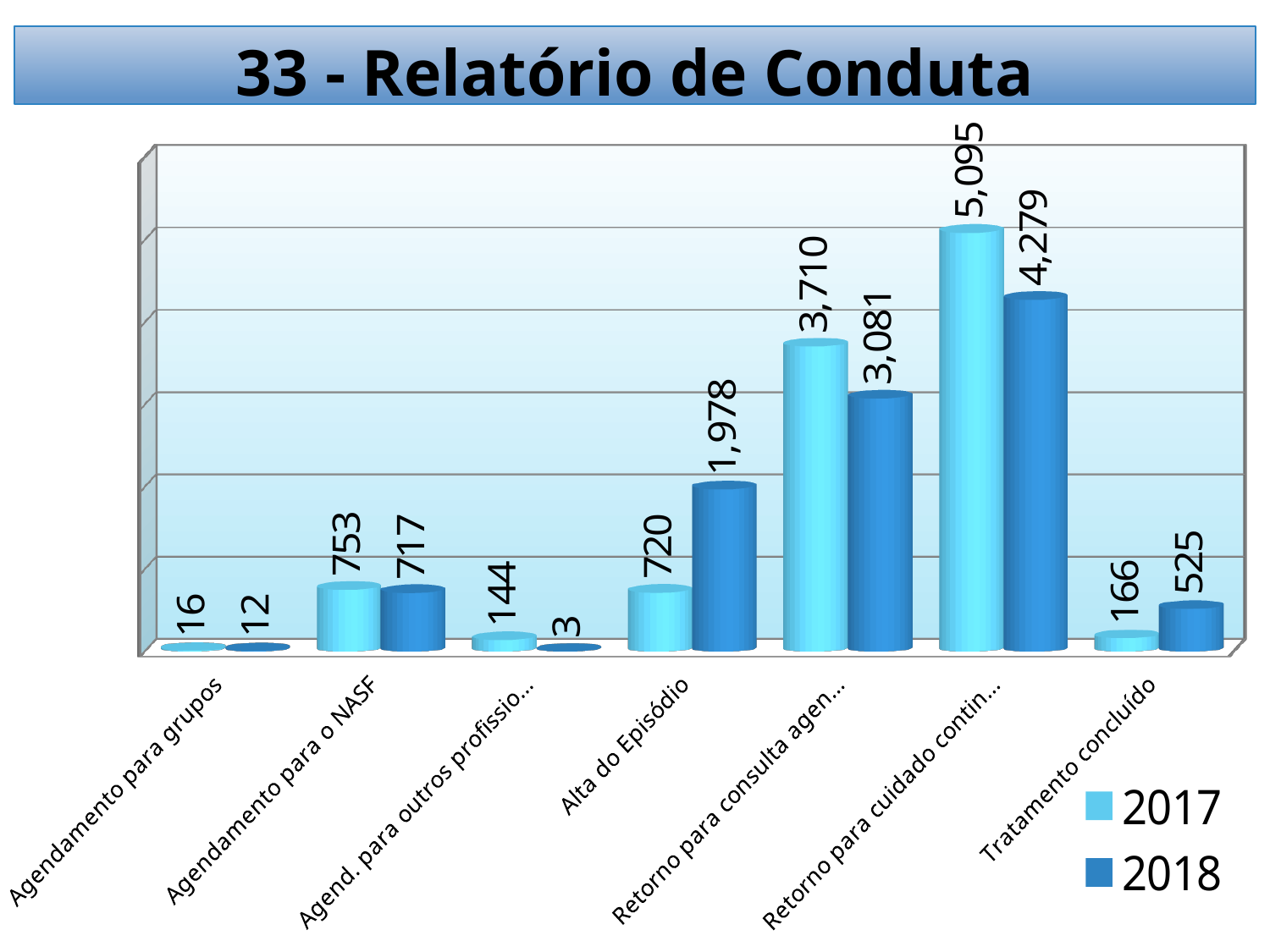
What is the difference between the 2017 and 2018 values for Agendamento para o NASF? 36 Which category has the lowest 2018 value? Agend. para outros profissio... How many categories are shown on the x axis? 7 Which category has the highest 2017 value? Retorno para cuidado contin... What is the 2018 value for Tratamento concluído? 525 What is the 2017 value for Agendamento para grupos? 16 How many series does the legend list? 2 For Tratamento concluído, which year has the larger value, 2017 or 2018? 2018 What is the 2017 value for Agendamento para o NASF? 753 What kind of chart is shown on the slide? Bar chart What is the 2018 value for Alta do Episódio? 1,978 What is the difference between the 2017 and 2018 values for Alta do Episódio? 1,258